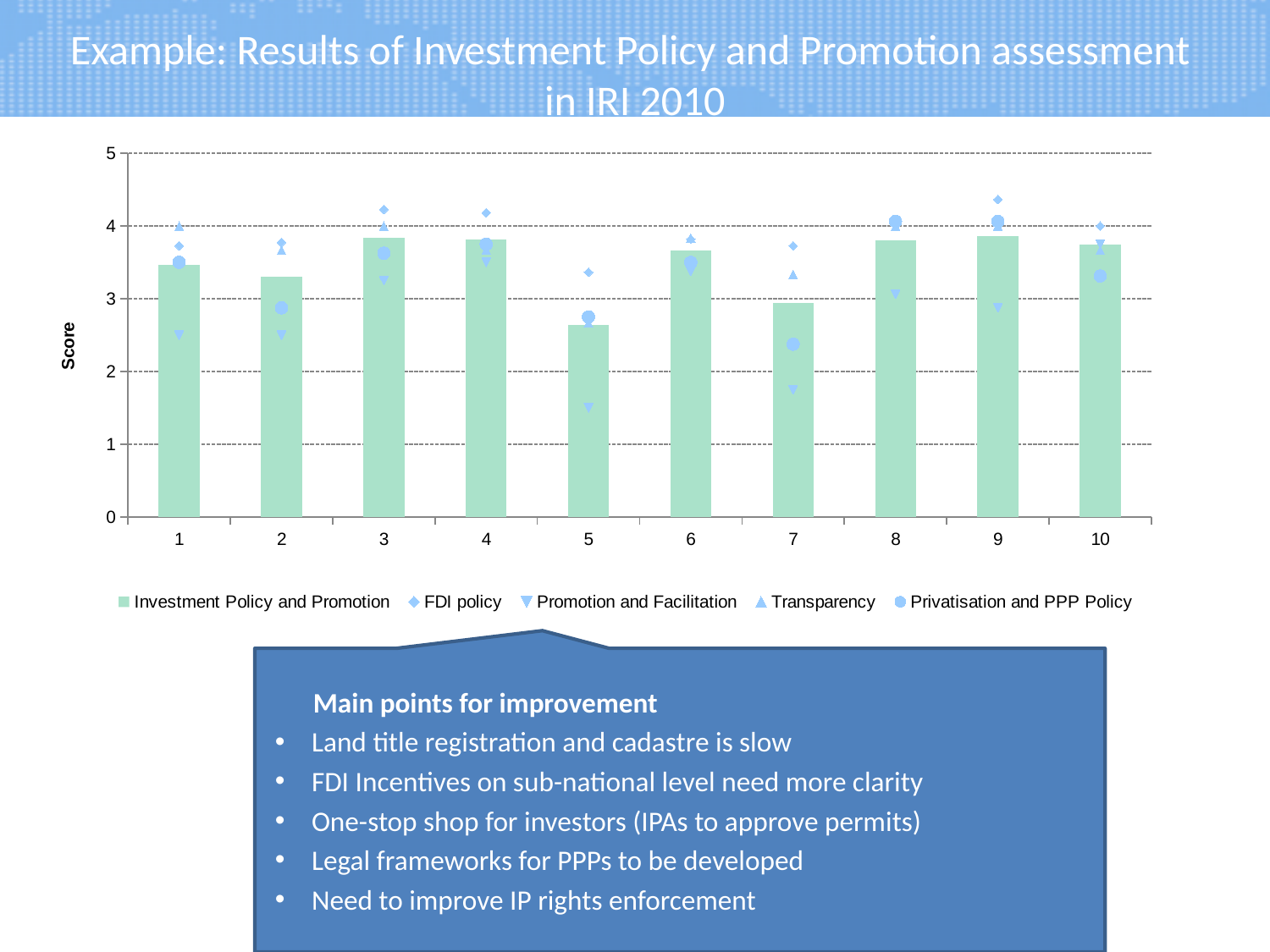
Is the Investment Policy and Promotion value for category 8 greater or less than 4? less Which category has the lowest Investment Policy and Promotion bar? 5 Is the Investment Policy and Promotion value for category 7 greater or less than 3? less Is the Investment Policy and Promotion value for category 5 greater or less than 3? less Which has the larger Investment Policy and Promotion bar, category 2 or category 7? category 2 How many series does the chart legend list? 5 Which has the larger Investment Policy and Promotion bar, category 5 or category 8? category 8 How many categories are shown along the x axis of the chart? 10 What is the title of the chart's vertical axis? Score What kind of chart is shown on the slide? combination bar and line chart